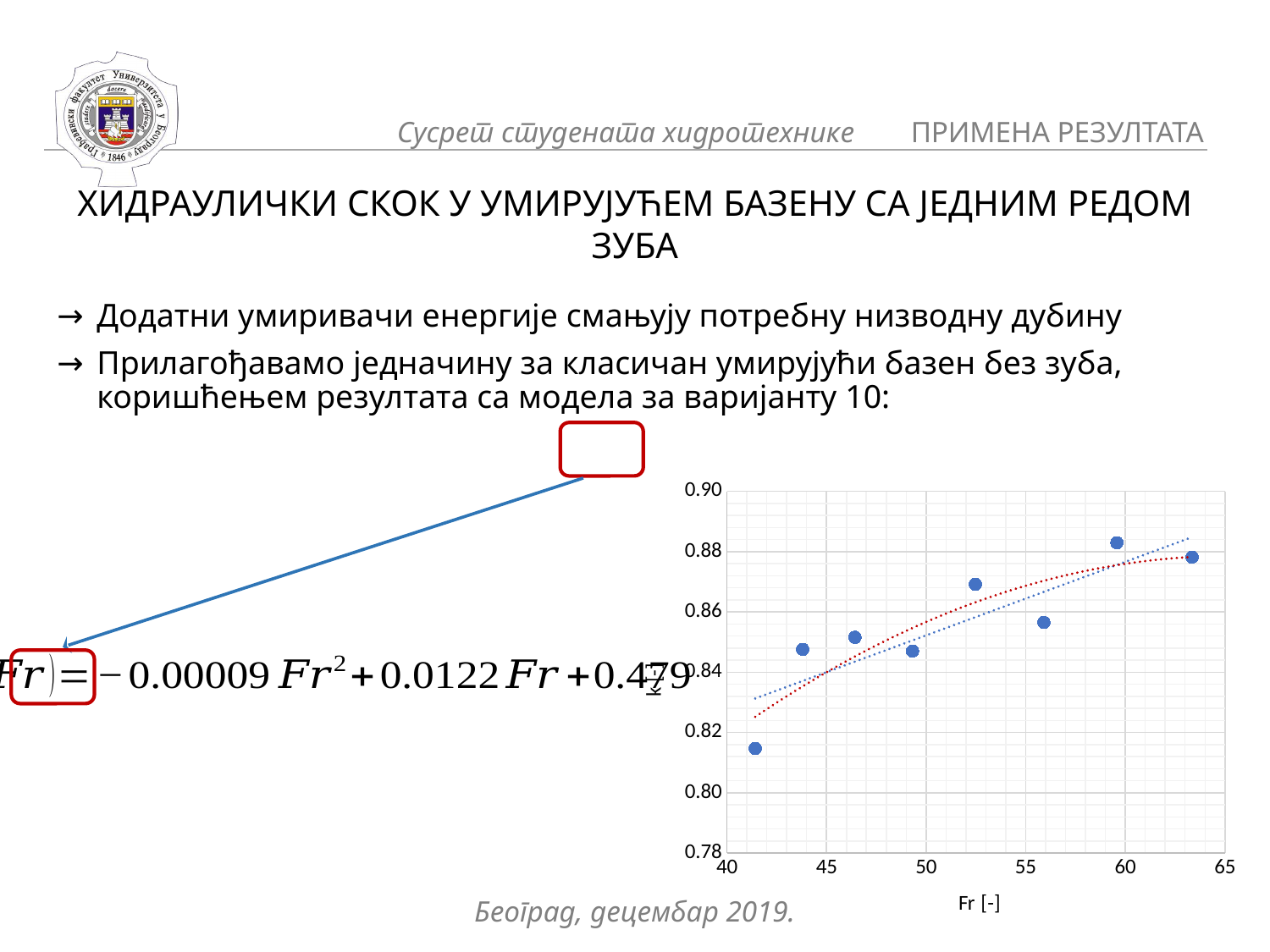
Is the value of the rightmost data point (at Fr of about 63) greater or less than 0.86? greater Is the value of the data point at Fr of about 56 greater or less than 0.86? less Is the value of the leftmost data point (at Fr of about 41) greater or less than 0.82? less What is the label of the x axis of the chart? Fr [-] How many data points are plotted in the chart? 8 Which data point has the lowest value: the one at Fr of about 41 or the one at Fr of about 63? the one at Fr of about 41 Do the plotted values generally rise or fall as Fr increases along the x axis? rise What is the maximum value shown on the y axis of the chart? 0.90 What kind of chart is shown on the slide? scatter chart